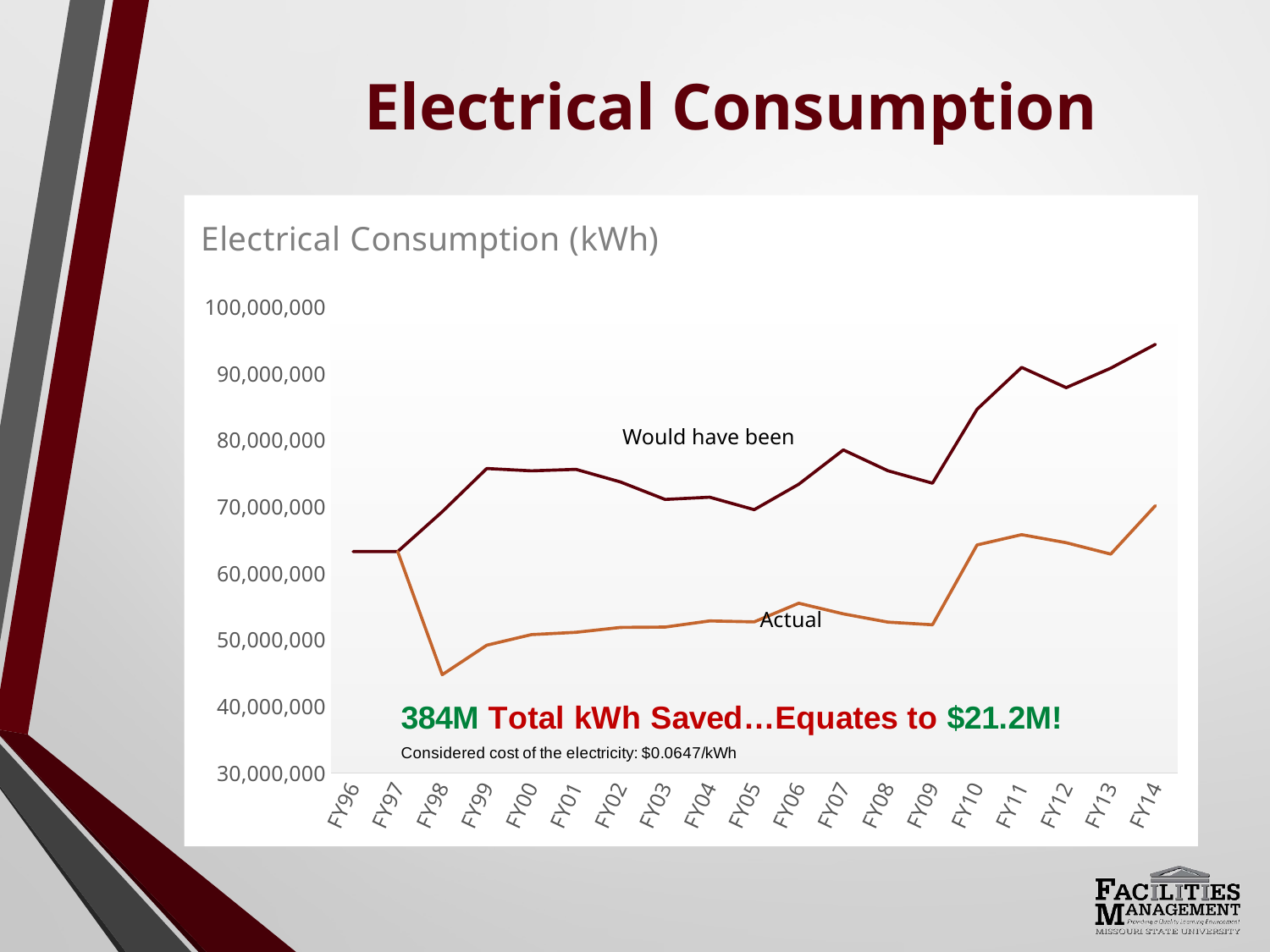
What kind of chart is shown on the slide? Line chart Is the Actual value for FY98 greater or less than 50,000,000? less Is the Actual value for FY10 greater or less than 60,000,000? greater What cost of electricity is stated on the chart? $0.0647/kWh How many fiscal years are plotted along the x axis? 19 How many data series are plotted in the chart? 2 Is the Would have been value for FY10 greater or less than 80,000,000? greater In FY10, which series has the larger value, Would have been or Actual? Would have been What is the title of the chart? Electrical Consumption (kWh) In which fiscal year is the Would have been series at its highest? FY14 In which fiscal year is the Actual series at its lowest? FY98